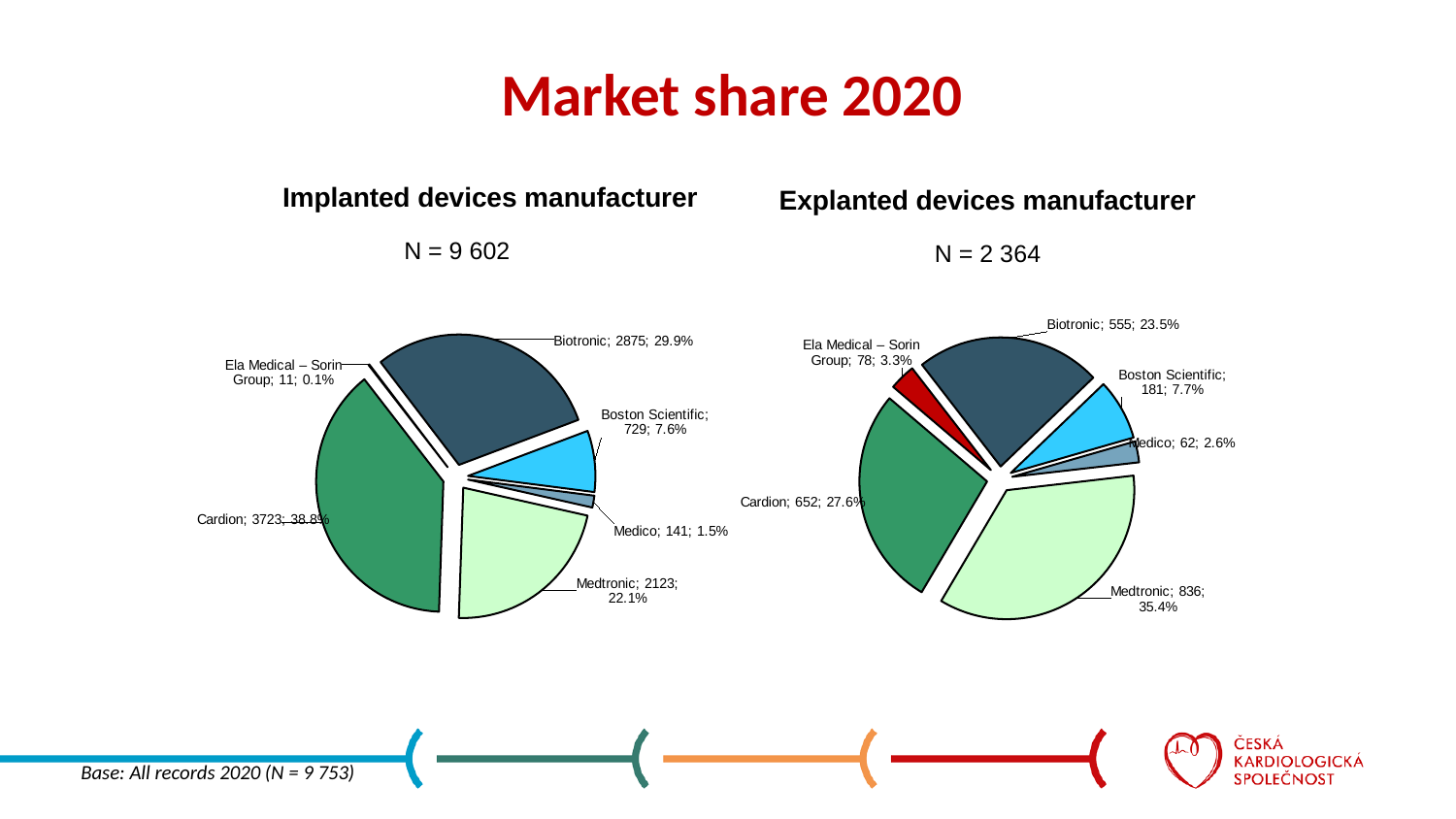
In the 'Explanted devices manufacturer' chart, what is the value for Medtronic? 836 What type of chart is used for the 'Explanted devices manufacturer' data? Pie chart What is the N value shown for the 'Explanted devices manufacturer' chart? N = 2 364 In the 'Explanted devices manufacturer' chart, which is larger, the value for Biotronic or the value for Cardion? Cardion In the 'Implanted devices manufacturer' chart, what is the value for Biotronic? 2875 In the 'Explanted devices manufacturer' chart, which manufacturer has the largest slice? Medtronic In the 'Explanted devices manufacturer' chart, what share of the pie does Boston Scientific hold? 7.7% In the 'Implanted devices manufacturer' chart, what share of the pie does Cardion hold? 38.8% In the 'Implanted devices manufacturer' chart, how many slices does the pie have? 6 In the 'Implanted devices manufacturer' chart, what is the difference between the Cardion and Medtronic values? 1600 In the 'Implanted devices manufacturer' chart, which manufacturer has the smallest slice? Ela Medical – Sorin Group In the 'Implanted devices manufacturer' chart, which manufacturer has the largest slice? Cardion